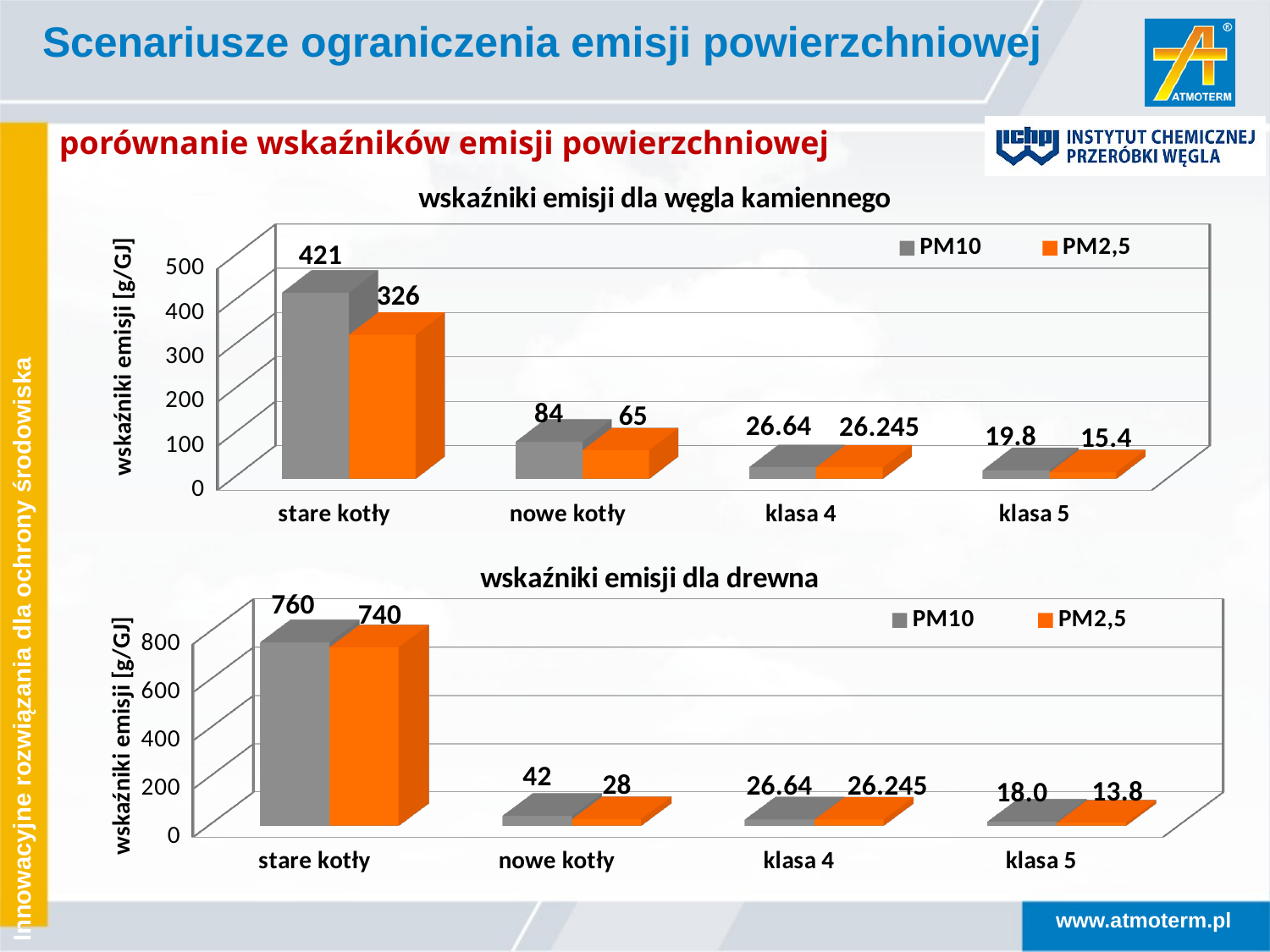
How many series does the legend of the chart 'wskaźniki emisji dla drewna' list? 2 In the chart 'wskaźniki emisji dla drewna', is the PM10 value for 'nowe kotły' larger or smaller than the PM10 value for 'klasa 4'? larger In the chart 'wskaźniki emisji dla węgla kamiennego', what is the PM2,5 value for 'nowe kotły'? 65 In the chart 'wskaźniki emisji dla drewna', which category has the highest PM10 value? stare kotły In the chart 'wskaźniki emisji dla węgla kamiennego', how many categories are shown on the x axis? 4 In the chart 'wskaźniki emisji dla węgla kamiennego', what is the difference between the PM10 and PM2,5 values for 'stare kotły'? 95 In the chart 'wskaźniki emisji dla drewna', what is the PM10 value for 'klasa 5'? 18.0 In the chart 'wskaźniki emisji dla węgla kamiennego', what is the PM10 value for 'stare kotły'? 421 In the chart 'wskaźniki emisji dla węgla kamiennego', which category has the lowest PM2,5 value? klasa 5 In the chart 'wskaźniki emisji dla drewna', what is the PM2,5 value for 'stare kotły'? 740 In the chart 'wskaźniki emisji dla drewna', what is the difference between the PM10 and PM2,5 values for 'nowe kotły'? 14 What kind of chart is 'wskaźniki emisji dla węgla kamiennego'? bar chart